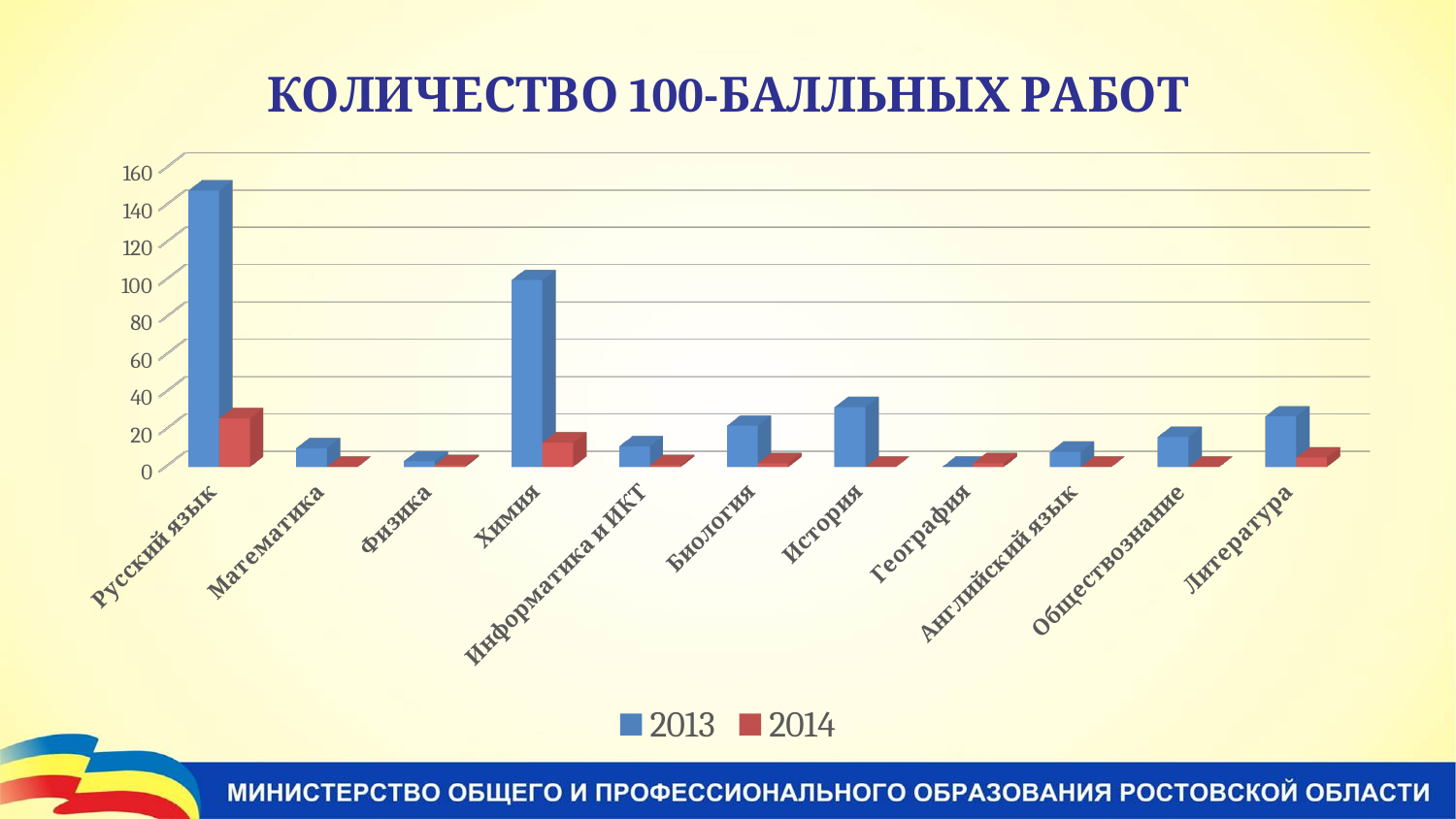
Which subject has the highest value for 2014? Русский язык Is the 2013 value for Химия greater or less than 80? greater Is the 2013 value for Русский язык greater or less than 120? greater Which subject has the lowest value for 2013? География How many series does the legend list? 2 Is the 2013 value for История greater or less than 40? less What is the title of the chart? КОЛИЧЕСТВО 100-БАЛЛЬНЫХ РАБОТ What kind of chart is shown on the slide? Bar chart How many subject categories are shown on the x axis? 11 Which subject has the highest value for 2013? Русский язык Which is larger for 2013: Химия or История? Химия